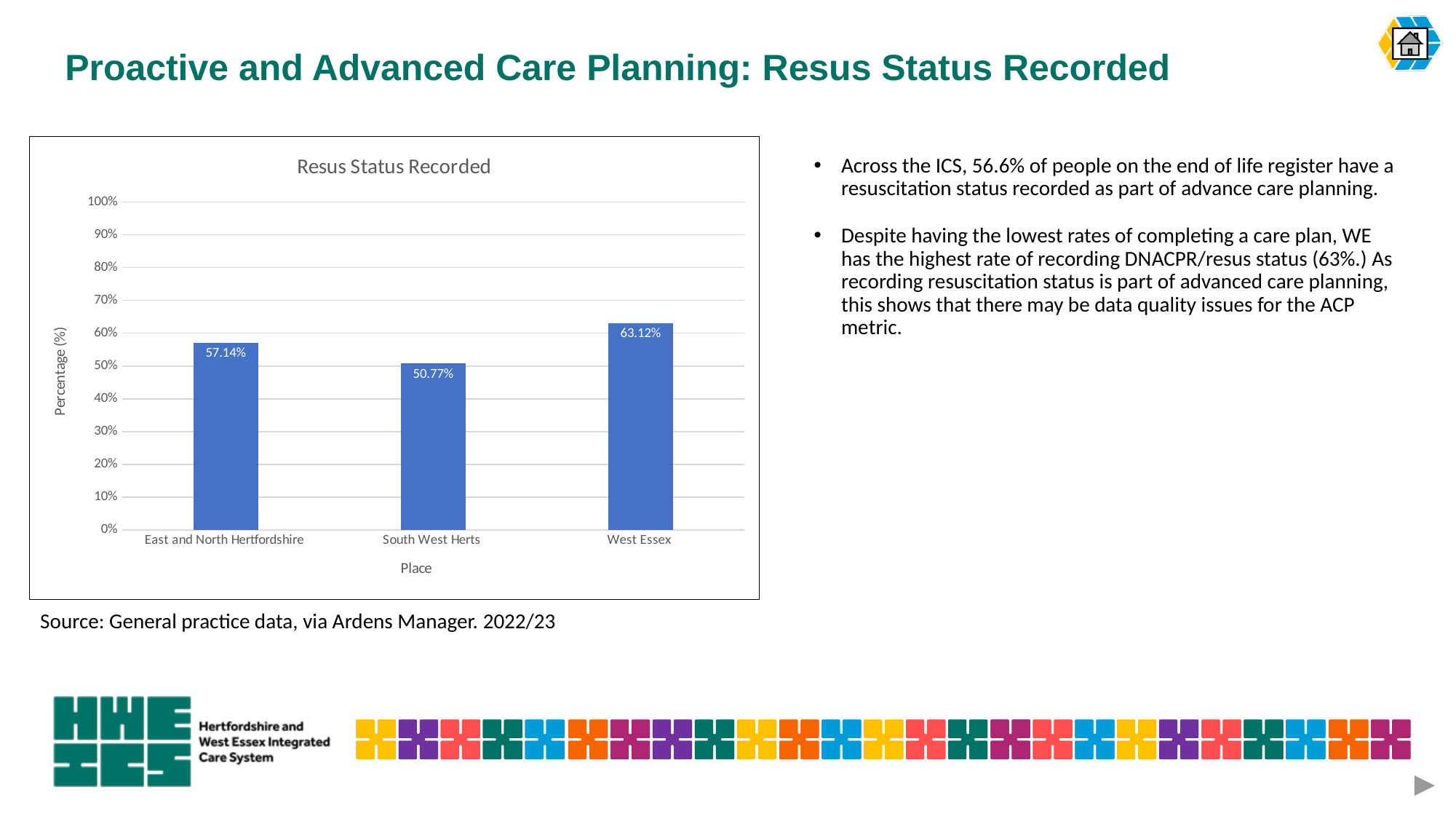
What kind of chart is shown on the slide? bar chart What is the title of the chart? Resus Status Recorded What is the value for West Essex? 63.12% Is the value for South West Herts greater or less than 60%? less Which place has the lowest percentage of resus status recorded? South West Herts What is the difference between the values for West Essex and South West Herts? 12.35% What is the difference between the values for East and North Hertfordshire and South West Herts? 6.37% Which place has the highest percentage of resus status recorded? West Essex What is the value for East and North Hertfordshire? 57.14% Which is larger, the value for East and North Hertfordshire or the value for West Essex? West Essex How many places are shown on the chart? 3 What is the value for South West Herts? 50.77%